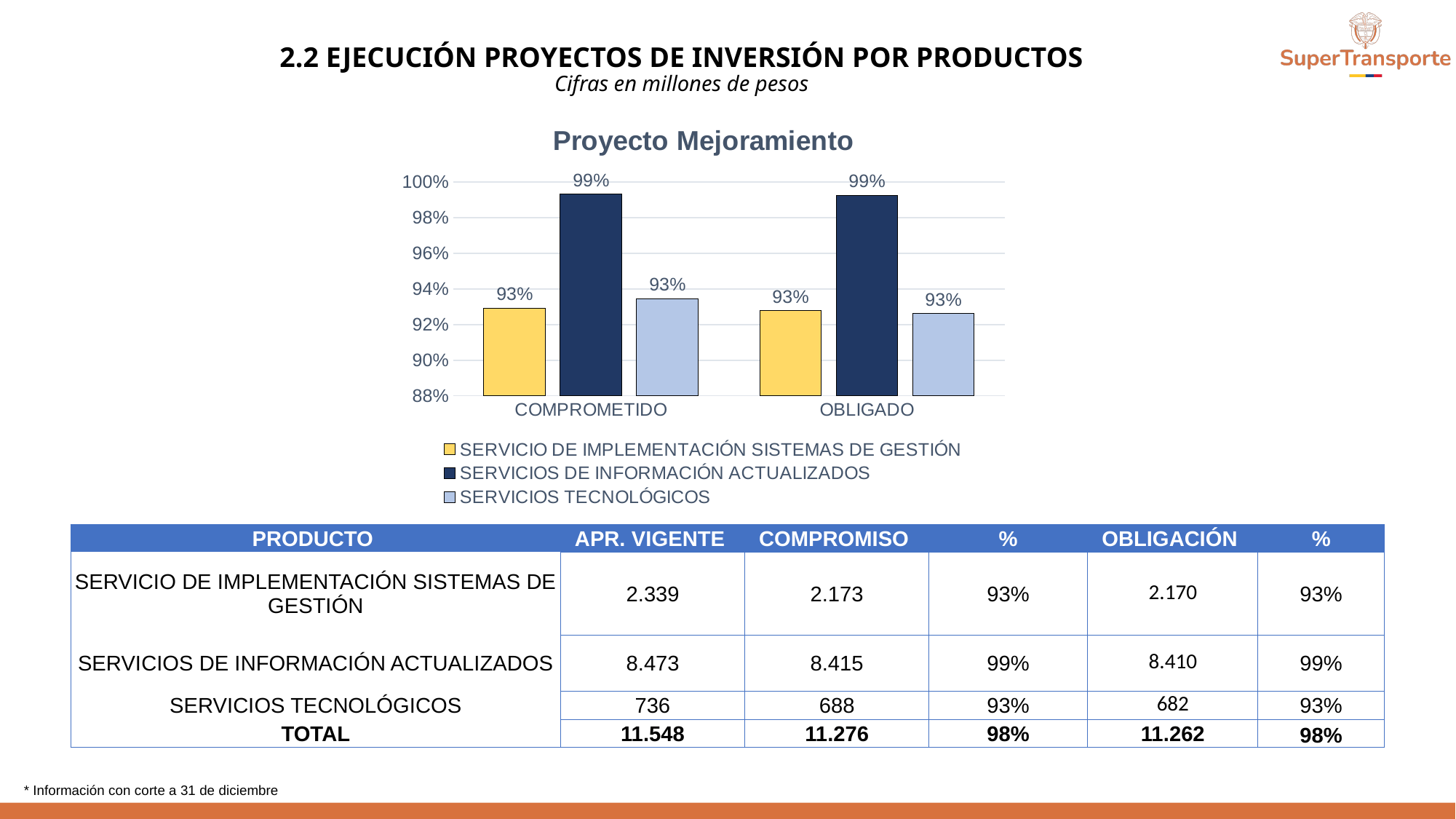
In the OBLIGADO category, which is larger: the value for SERVICIOS DE INFORMACIÓN ACTUALIZADOS or the value for SERVICIOS TECNOLÓGICOS? SERVICIOS DE INFORMACIÓN ACTUALIZADOS What is the value for SERVICIOS TECNOLÓGICOS in the COMPROMETIDO category? 93% How many series does the chart legend list? 3 What is the value for SERVICIO DE IMPLEMENTACIÓN SISTEMAS DE GESTIÓN in the OBLIGADO category? 93% Is the value for SERVICIO DE IMPLEMENTACIÓN SISTEMAS DE GESTIÓN in the COMPROMETIDO category greater or less than 96%? less Which series has the highest value in the OBLIGADO category? SERVICIOS DE INFORMACIÓN ACTUALIZADOS What is the difference between the SERVICIOS DE INFORMACIÓN ACTUALIZADOS value and the SERVICIOS TECNOLÓGICOS value in the COMPROMETIDO category? 6% What is the title of the chart? Proyecto Mejoramiento How many categories are shown on the x axis of the chart? 2 Which colour represents SERVICIOS DE INFORMACIÓN ACTUALIZADOS in the chart? dark blue What type of chart is shown under the title "Proyecto Mejoramiento"? bar chart What is the value for SERVICIOS DE INFORMACIÓN ACTUALIZADOS in the COMPROMETIDO category? 99%